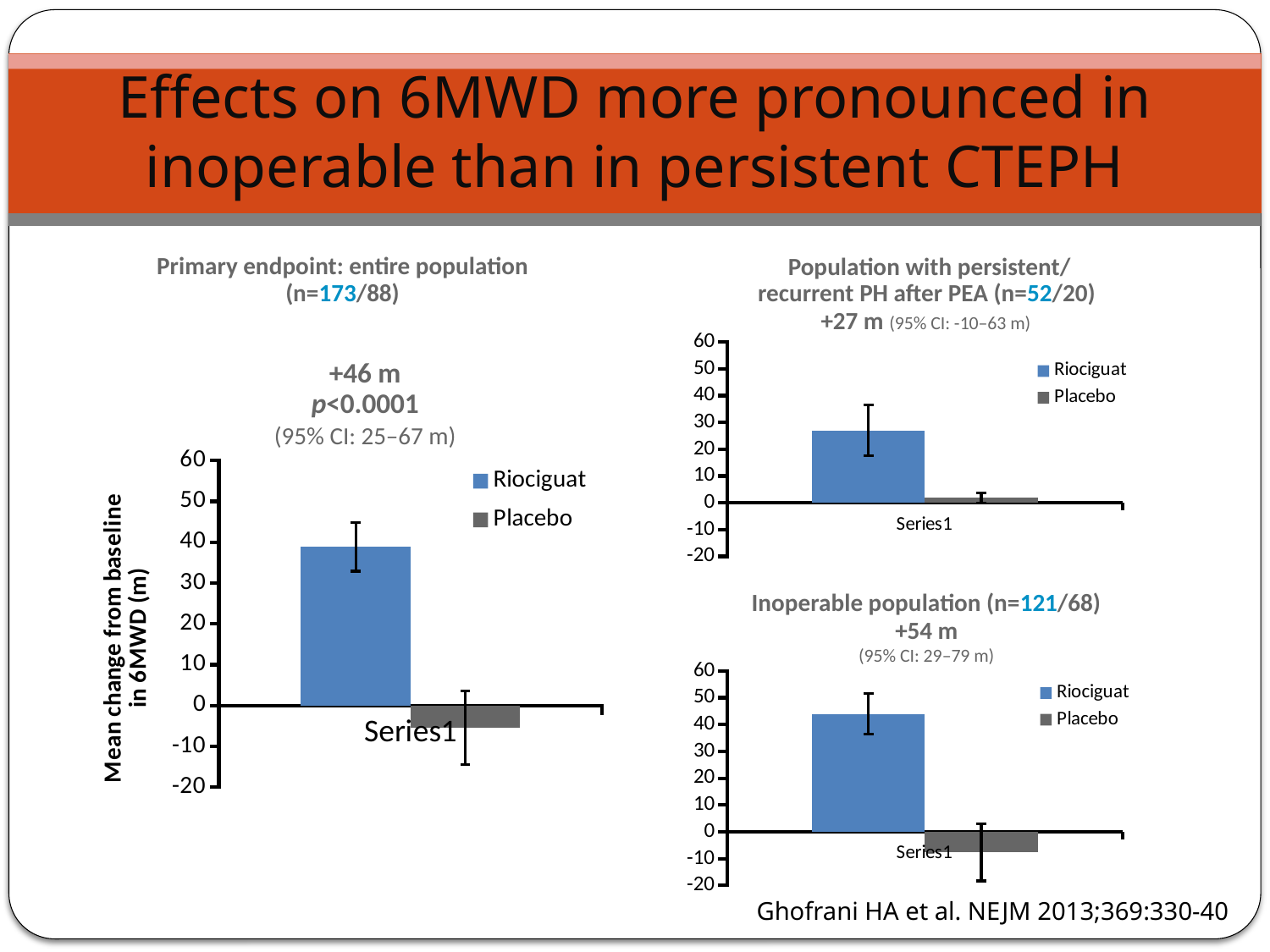
What colour is the Riociguat series in the 'Inoperable population' chart? blue In the 'Primary endpoint: entire population' chart, which series has the larger value, Riociguat or Placebo? Riociguat What is the y-axis label of the 'Primary endpoint: entire population' chart? Mean change from baseline in 6MWD (m) In the 'Population with persistent/recurrent PH after PEA' chart, which series has the larger value, Riociguat or Placebo? Riociguat In the 'Inoperable population' chart, is the value for Riociguat greater or less than 40? greater In the 'Primary endpoint: entire population' chart, is the value for Riociguat greater or less than 30? greater In the 'Primary endpoint: entire population' chart, is the value for Placebo greater or less than 0? less How many series does the legend list in the 'Primary endpoint: entire population' chart? 2 Which chart shows the higher Riociguat bar, the 'Population with persistent/recurrent PH after PEA' chart or the 'Inoperable population' chart? Inoperable population What kind of chart is the 'Primary endpoint: entire population' chart? bar chart